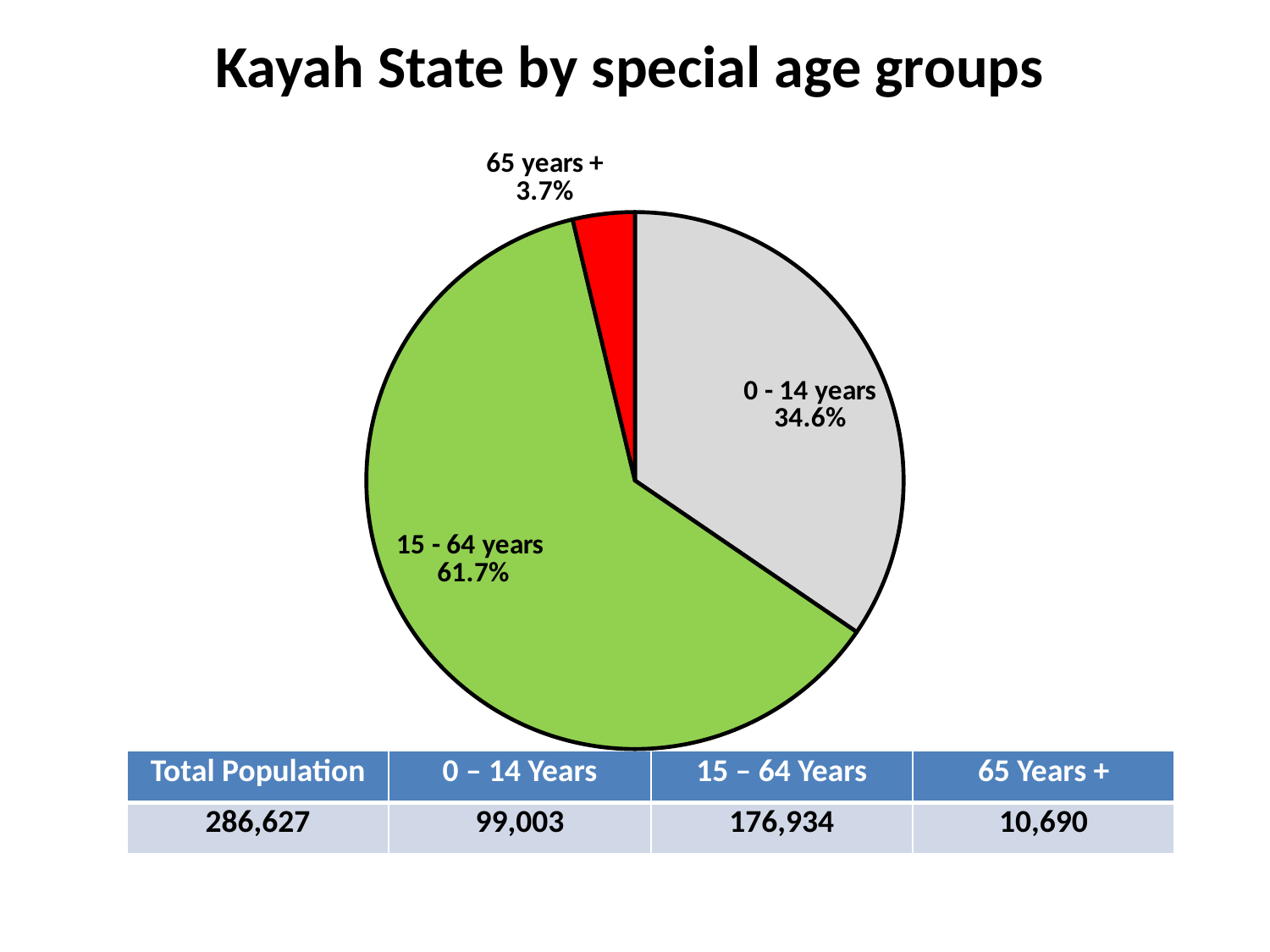
Is the share for the 0 - 14 years slice greater or less than 50%? less What is the difference in percentage points between the 15 - 64 years slice and the 0 - 14 years slice? 27.1 How many slices does the pie chart have? 3 What colour is the 15 - 64 years slice of the pie? green What kind of chart is shown on the slide? pie chart What share of the pie does the 0 - 14 years slice represent? 34.6% What share of the pie does the 15 - 64 years slice represent? 61.7% Which age group has the largest slice of the pie? 15 - 64 years Which slice is larger, 0 - 14 years or 65 years +? 0 - 14 years What share of the pie does the 65 years + slice represent? 3.7% What is the title of the slide containing the pie chart? Kayah State by special age groups Which age group has the smallest slice of the pie? 65 years +